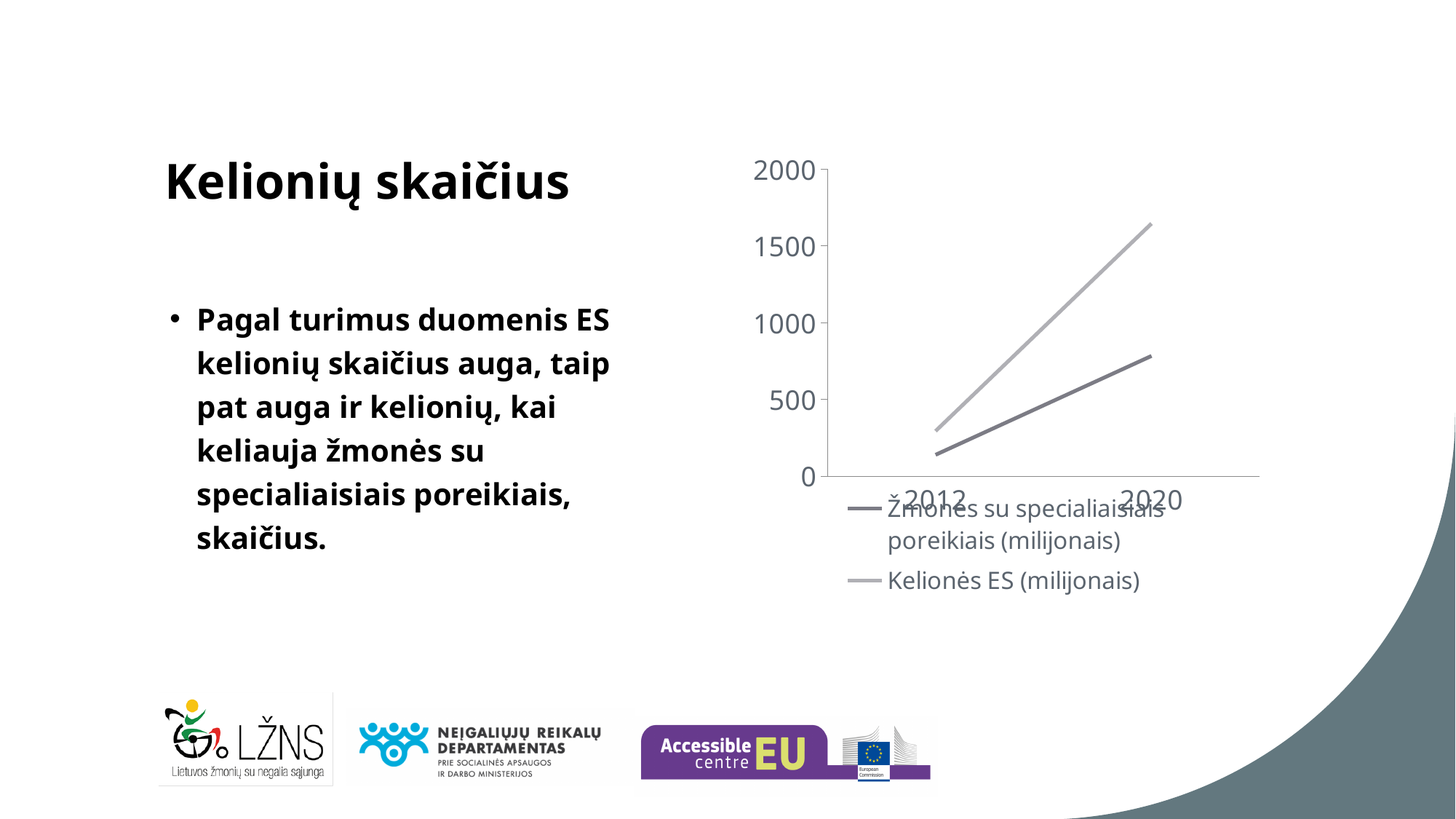
What kind of chart is shown on the slide? line chart Which years are shown on the x axis of the chart? 2012 and 2020 Does the 'Žmonės su specialiaisiais poreikiais (milijonais)' line rise or fall from 2012 to 2020? rise Is the value for 'Kelionės ES (milijonais)' in 2012 greater or less than 500? less Does the 'Kelionės ES (milijonais)' line rise or fall from 2012 to 2020? rise In 2020, which series has the higher value: 'Kelionės ES (milijonais)' or 'Žmonės su specialiaisiais poreikiais (milijonais)'? Kelionės ES (milijonais) Is the value for 'Žmonės su specialiaisiais poreikiais (milijonais)' in 2020 greater or less than 1000? less How many series does the chart legend list? 2 Is the value for 'Žmonės su specialiaisiais poreikiais (milijonais)' in 2020 greater or less than 500? greater What is the highest value shown on the y axis of the chart? 2000 How many years are shown on the x axis of the chart? 2